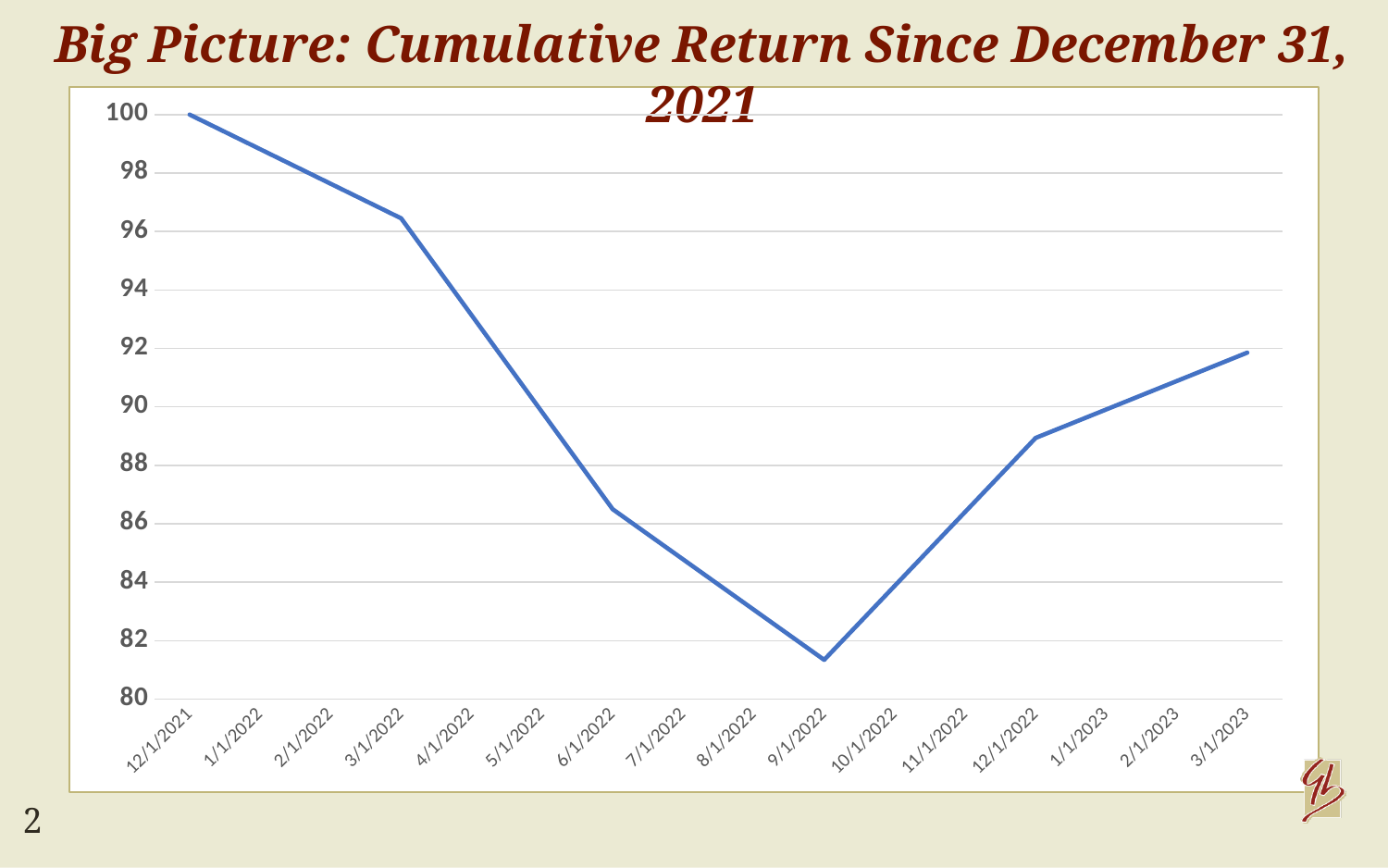
At which date does the line reach its highest point? 12/1/2021 What is the value of the line at 12/1/2021? 100 Is the value at 3/1/2023 greater or less than 90? greater What kind of chart is shown on the slide? line chart Which is larger, the value at 12/1/2022 or the value at 3/1/2023? 3/1/2023 Does the line rise or fall between 12/1/2021 and 9/1/2022? fall At which date does the line reach its lowest point? 9/1/2022 Is the value at 3/1/2022 greater or less than 96? greater Is the value at 9/1/2022 greater or less than 82? less How many date labels are shown on the x axis? 16 Does the line rise or fall between 9/1/2022 and 3/1/2023? rise